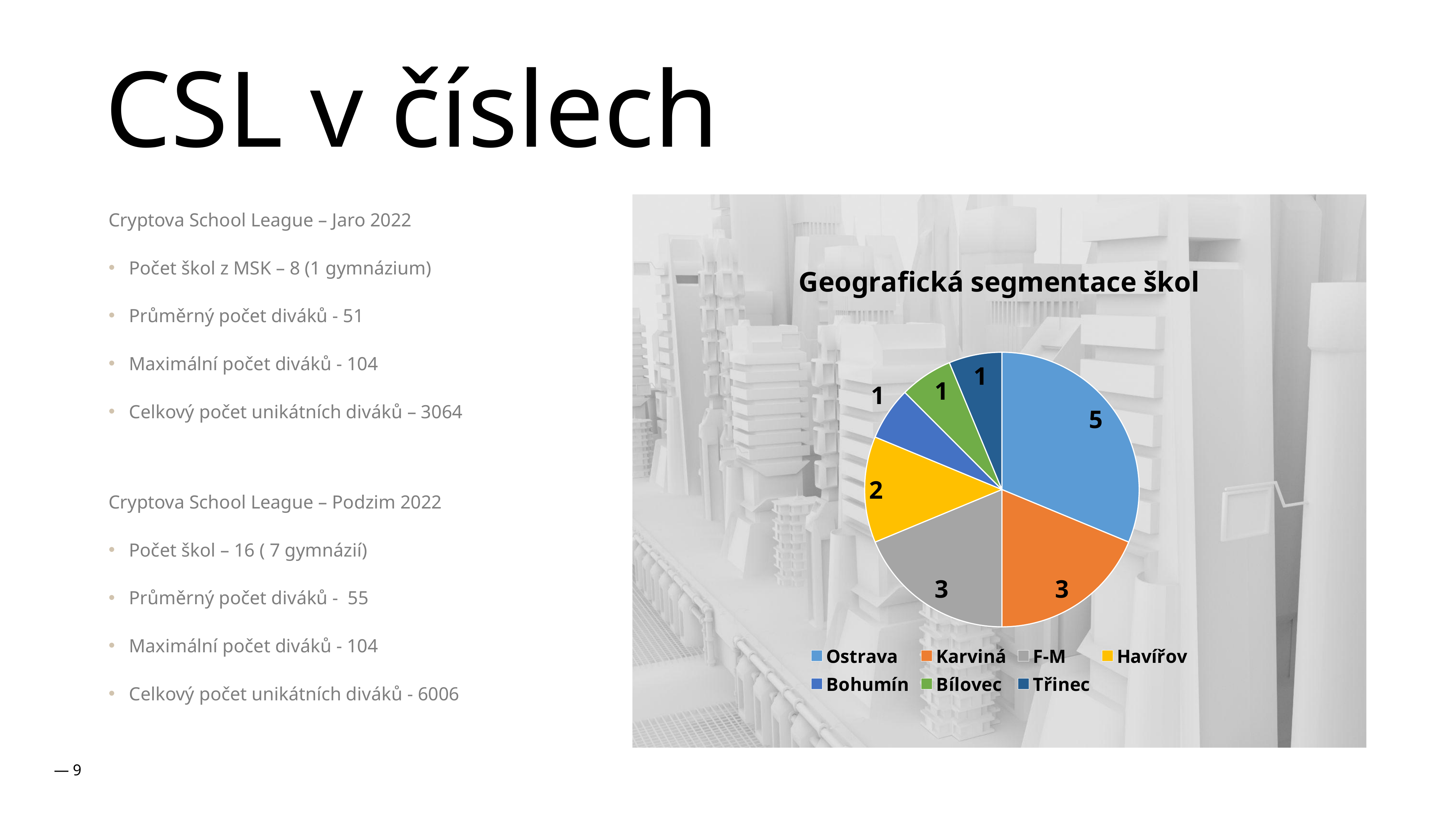
What is the value for Ostrava in the pie chart? 5 What is the total of all slices in the pie chart? 16 Which category has the largest slice in the pie chart? Ostrava What is the title of the chart? Geografická segmentace škol How many categories does the pie chart have? 7 What is the value for Havířov in the pie chart? 2 What type of chart is shown on the slide? pie chart What is the value for Třinec in the pie chart? 1 What is the difference between the values for Ostrava and Havířov? 3 Which is larger, the value for F-M or the value for Bohumín? F-M What is the value for Karviná in the pie chart? 3 What share of the pie does Ostrava represent? 31.25%